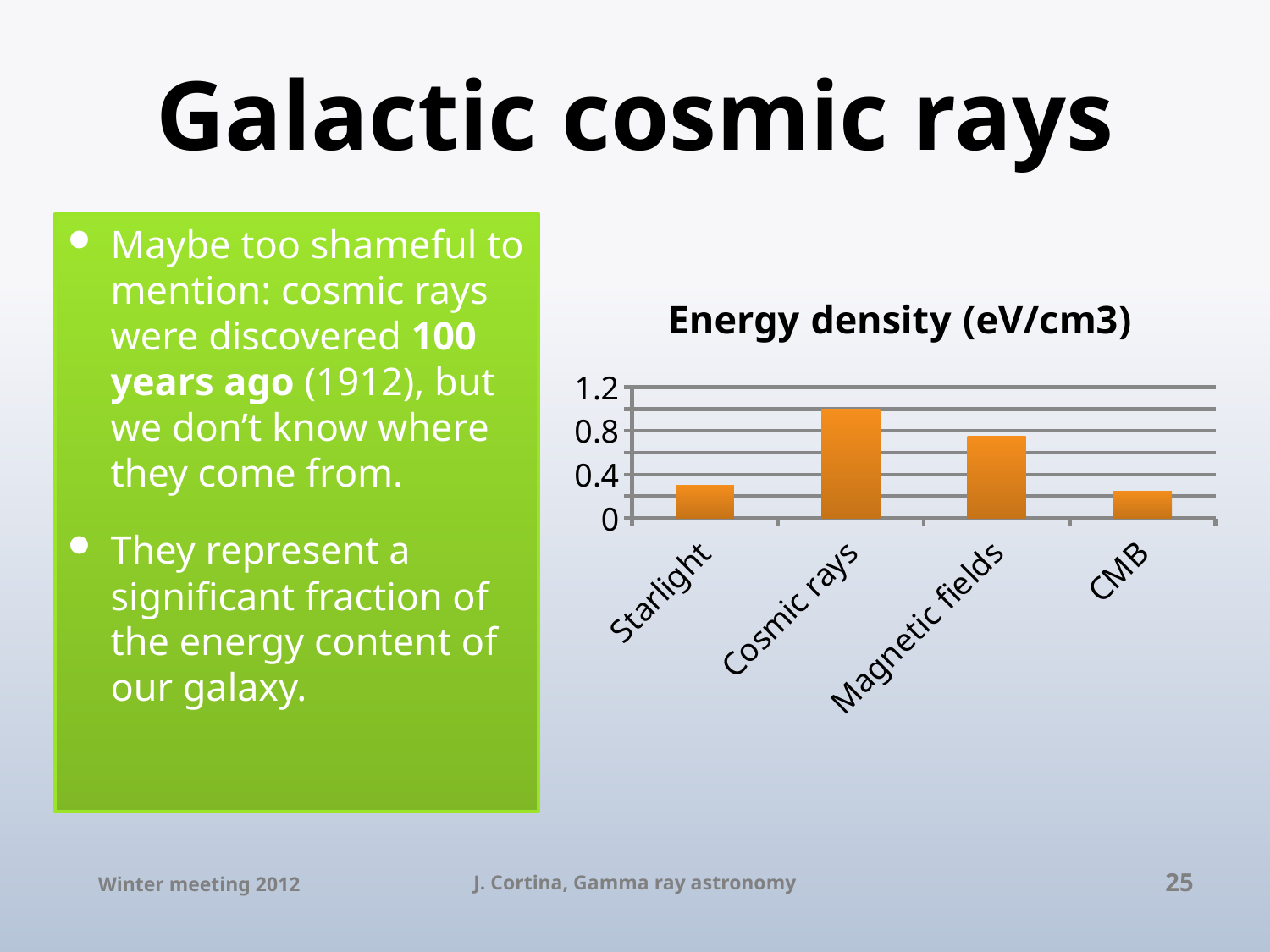
Is the value for CMB greater or less than 0.4? less Is the value for Cosmic rays greater or less than 0.8? greater Which has the larger energy density, Starlight or Magnetic fields? Magnetic fields Which has the larger energy density, Cosmic rays or Magnetic fields? Cosmic rays Is the value for Cosmic rays greater or less than 1.2? less Which category has the highest energy density in the chart? Cosmic rays What is the label of the first category on the x axis of the chart? Starlight What kind of chart is shown on the slide? bar chart How many categories are plotted in the Energy density chart? 4 What is the title of the chart? Energy density (eV/cm3)